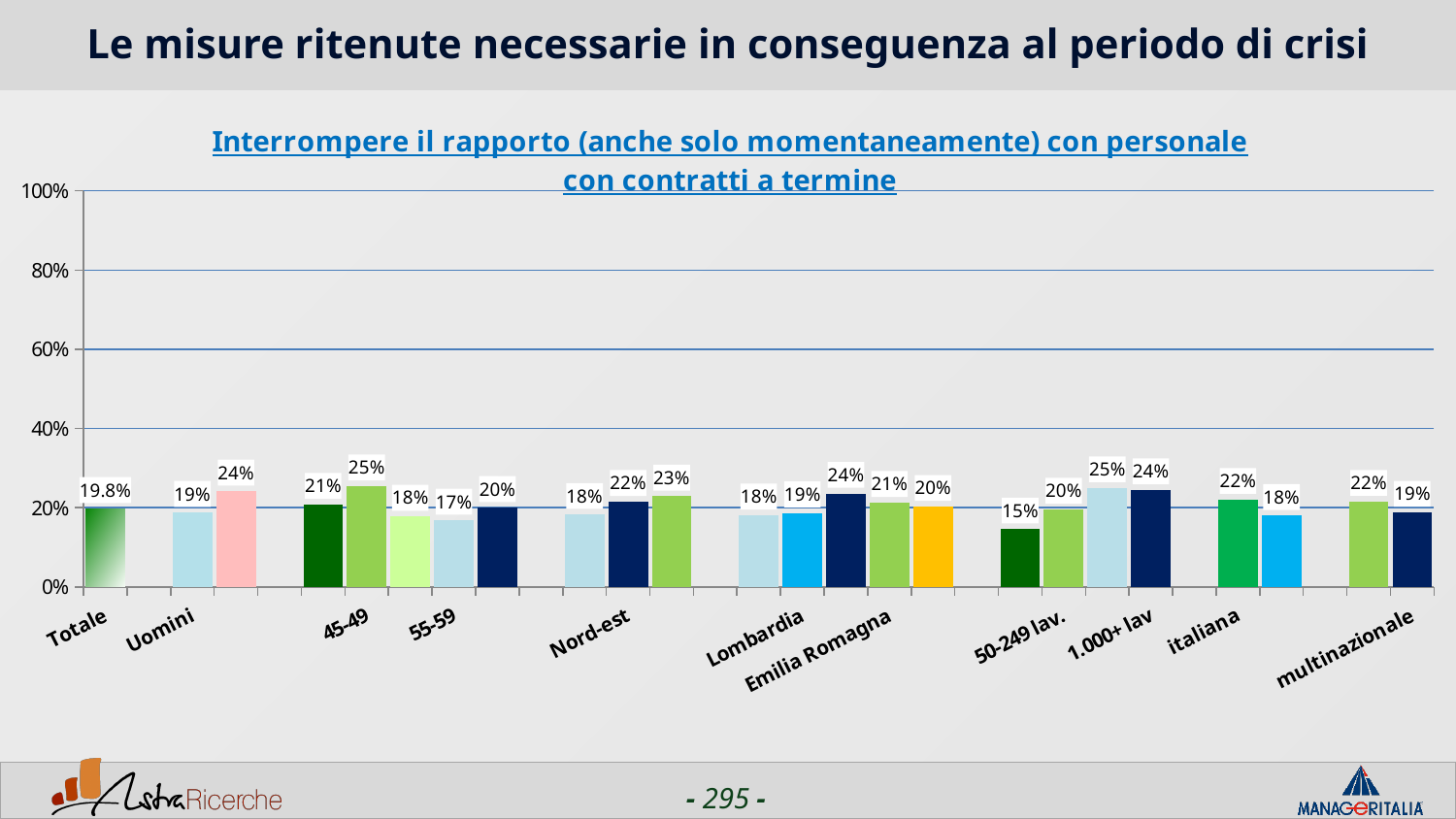
What is the value for 1.000+ lav? 24% What is the value for 55-59? 17% What is the value for 50-249 lav.? 20% What is the difference between the values for 1.000+ lav and 50-249 lav.? 4 percentage points What is the value for Totale? 19.8% Is the value for Totale greater or less than 40%? less What kind of chart is shown on the slide? bar chart What is the value for multinazionale? 19% Which is larger, the value for 45-49 or the value for 55-59? 45-49 What is the lowest value shown on any bar in the chart? 15% What is the value for Uomini? 19% What is the title of the chart? Interrompere il rapporto (anche solo momentaneamente) con personale con contratti a termine